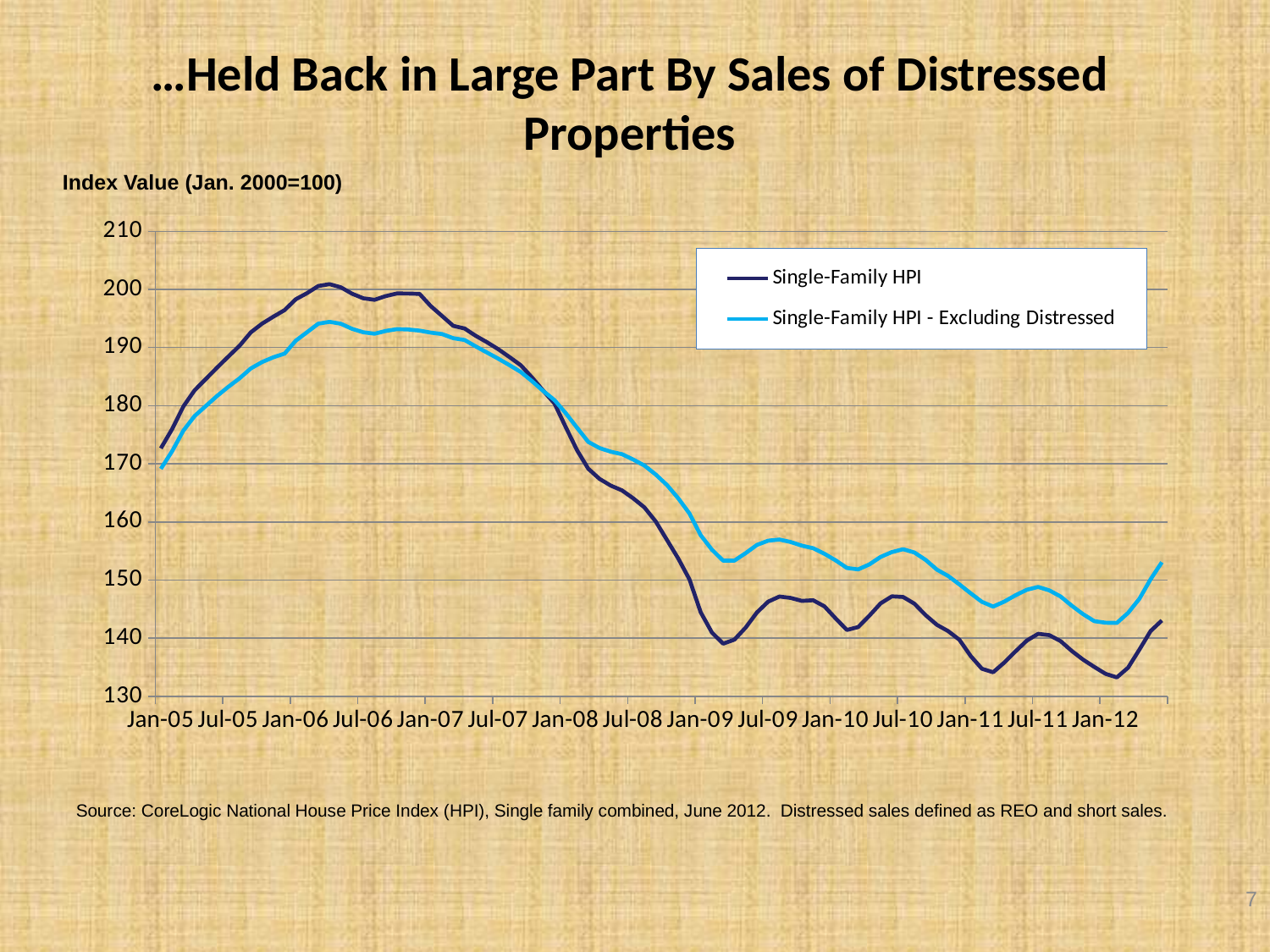
Does the Single-Family HPI series rise or fall between Jan-06 and Jan-09? fall How many series does the legend list? 2 Is the value of Single-Family HPI - Excluding Distressed at Jan-11 greater or less than 140? greater At Jan-06, which series has the higher value, Single-Family HPI or Single-Family HPI - Excluding Distressed? Single-Family HPI What are the two series named in the legend? Single-Family HPI; Single-Family HPI - Excluding Distressed At Jan-12, which series has the higher value, Single-Family HPI or Single-Family HPI - Excluding Distressed? Single-Family HPI - Excluding Distressed Is the value of Single-Family HPI at Jan-11 greater or less than 140? less Is the value of Single-Family HPI at Jan-05 greater or less than 170? greater What is the label above the vertical axis of the chart? Index Value (Jan. 2000=100) What kind of chart is shown on the slide? line chart